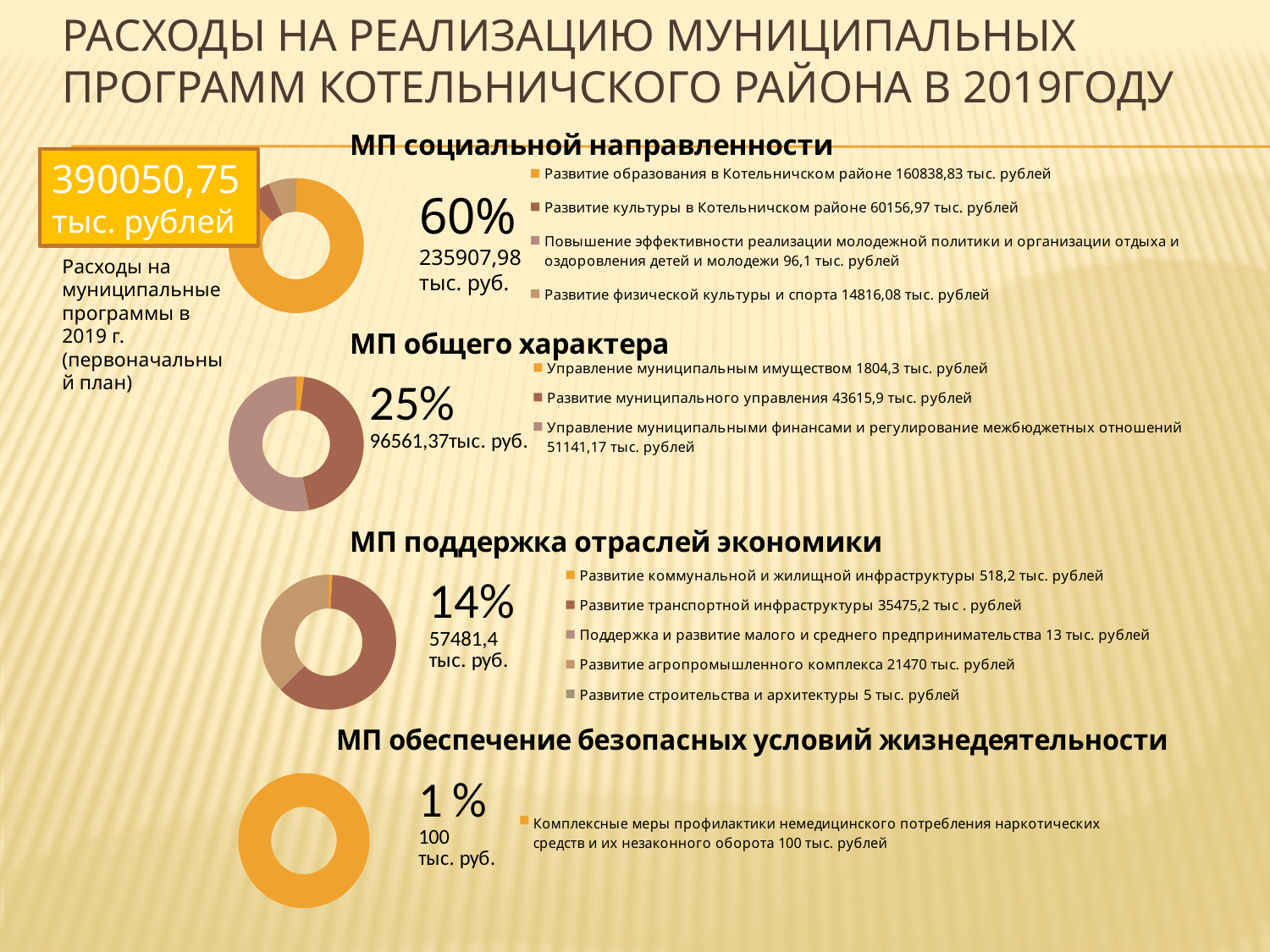
What total amount is shown next to the "МП поддержка отраслей экономики" chart? 57481,4 тыс. руб. In the "МП общего характера" chart, which category has the largest value? Управление муниципальными финансами и регулирование межбюджетных отношений In the "МП социальной направленности" chart, which category has the smallest value? Повышение эффективности реализации молодежной политики и организации отдыха и оздоровления детей и молодежи In the "МП общего характера" chart, what is the value for "Развитие муниципального управления"? 43615,9 тыс. рублей How many categories does the legend of the "МП социальной направленности" chart list? 4 In the "МП общего характера" chart, what is the difference between "Управление муниципальными финансами и регулирование межбюджетных отношений" and "Развитие муниципального управления"? 7525,27 тыс. рублей In the "МП поддержка отраслей экономики" chart, what is the value for "Развитие строительства и архитектуры"? 5 тыс. рублей What percentage is shown next to the "МП обеспечение безопасных условий жизнедеятельности" chart? 1 % How many categories does the legend of the "МП поддержка отраслей экономики" chart list? 5 In the "МП социальной направленности" chart, what is the value for "Развитие образования в Котельничском районе"? 160838,83 тыс. рублей What kind of chart is used for "МП социальной направленности"? Doughnut chart In the "МП поддержка отраслей экономики" chart, which is larger: "Развитие транспортной инфраструктуры" or "Развитие агропромышленного комплекса"? Развитие транспортной инфраструктуры